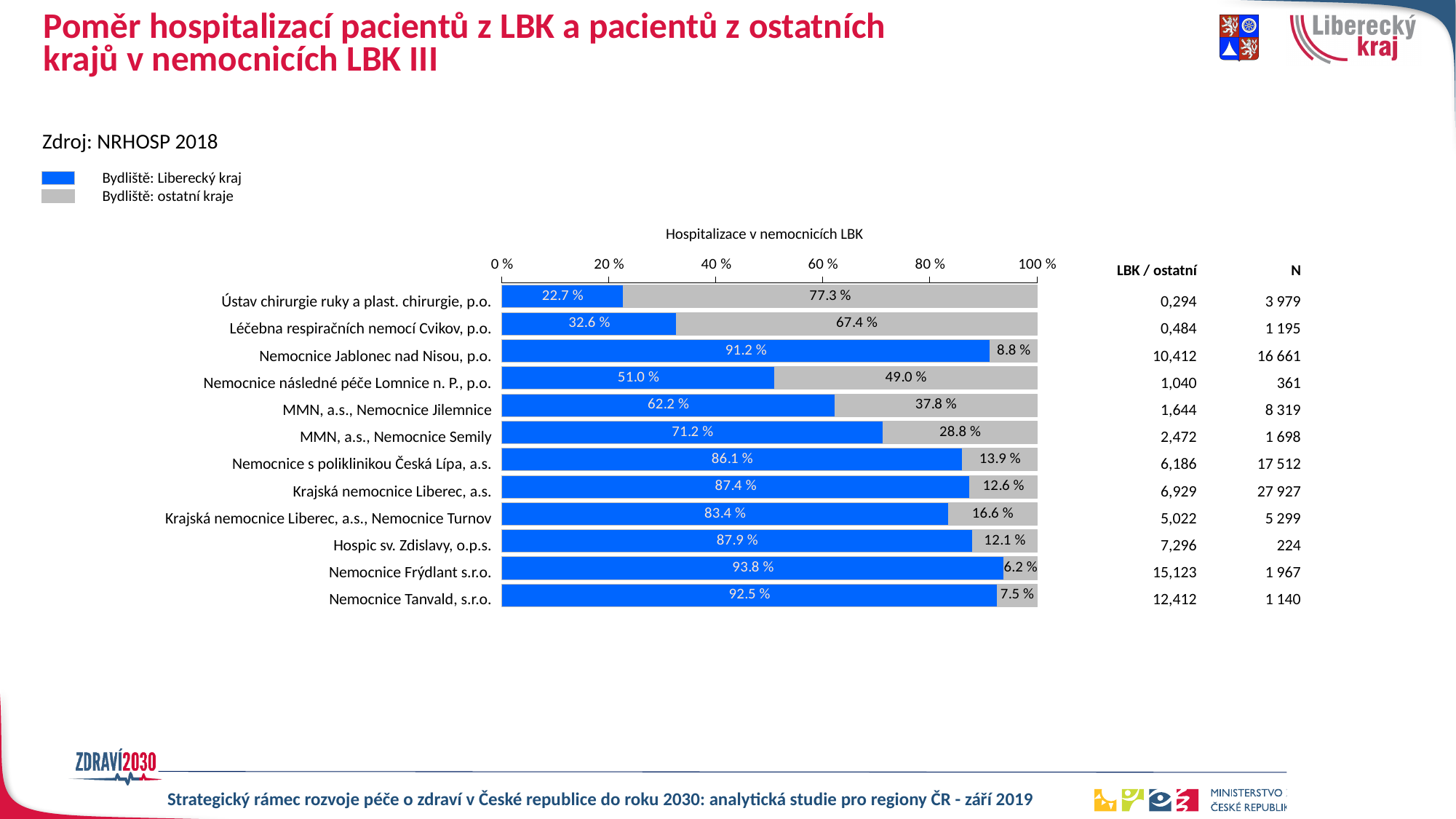
Is the Liberecký kraj share for Léčebna respiračních nemocí Cvikov, p.o. greater or less than 40 %? less How many series does the legend list? 2 What is the title of the chart's horizontal axis? Hospitalizace v nemocnicích LBK Which has a larger share of patients from Liberecký kraj: MMN, a.s., Nemocnice Semily or MMN, a.s., Nemocnice Jilemnice? MMN, a.s., Nemocnice Semily What is the difference in percentage points between the Liberecký kraj share for Nemocnice Tanvald, s.r.o. and for Nemocnice Jablonec nad Nisou, p.o.? 1.3 percentage points What is the share of patients with residence in Liberecký kraj (Bydliště: Liberecký kraj) for Nemocnice Jablonec nad Nisou, p.o.? 91.2 % Which hospital has the highest share of patients with residence in Liberecký kraj? Nemocnice Frýdlant s.r.o. Which hospital has the lowest share of patients with residence in Liberecký kraj? Ústav chirurgie ruky a plast. chirurgie, p.o. What is the share of patients from other regions (Bydliště: ostatní kraje) for MMN, a.s., Nemocnice Jilemnice? 37.8 % What kind of chart is shown on the slide? Stacked bar chart What is the share of patients with residence in Liberecký kraj for Hospic sv. Zdislavy, o.p.s.? 87.9 % How many hospitals (categories) are listed in the chart? 12